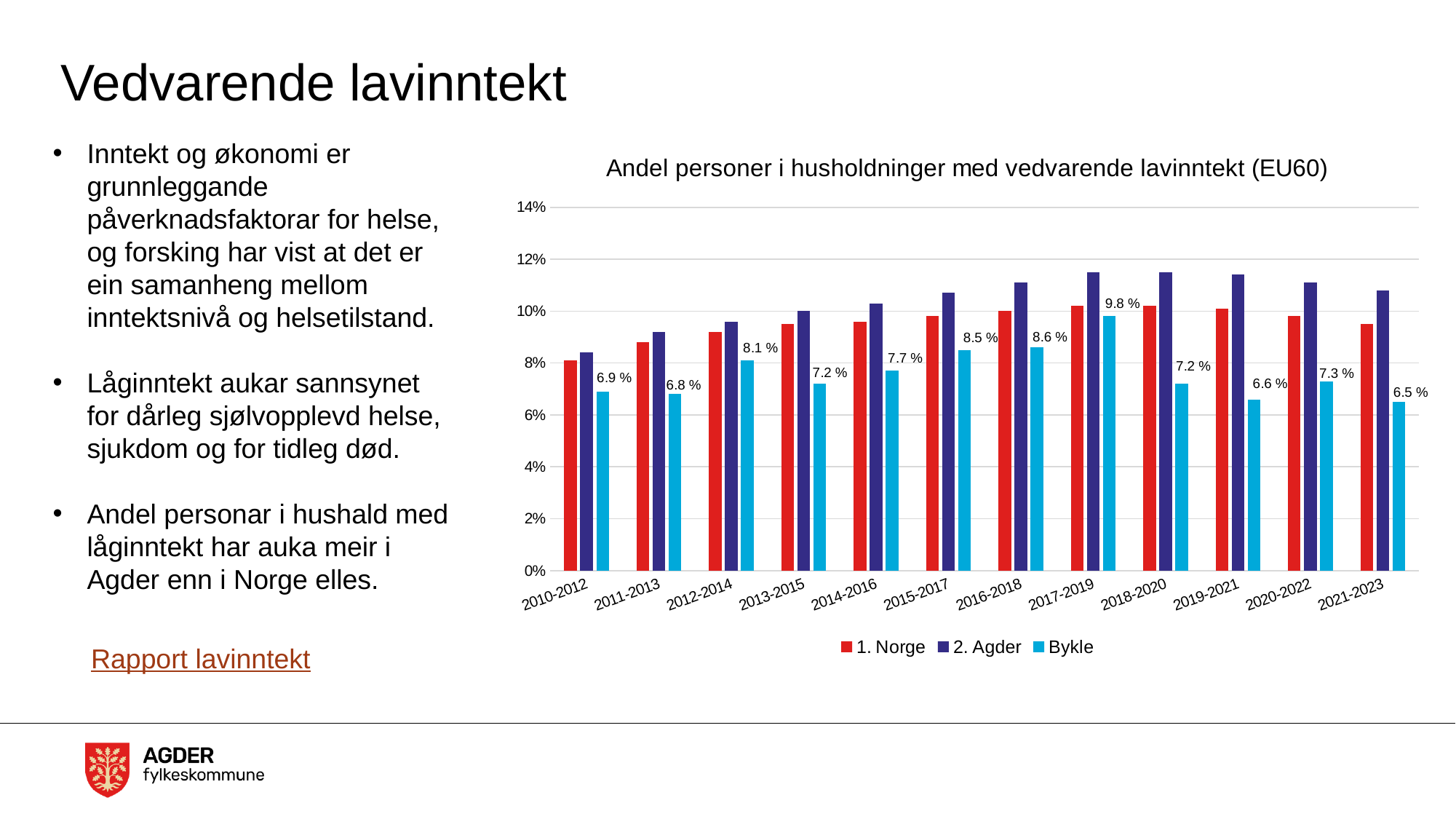
What is the difference between the Bykle value in 2017-2019 and in 2021-2023? 3.3 percentage points In which period is the Bykle value lowest? 2021-2023 What kind of chart is shown on the slide? Bar chart What is the value for Bykle in 2021-2023? 6.5 % How many series does the legend list? 3 What is the value for Bykle in 2017-2019? 9.8 % What is the value for Bykle in 2010-2012? 6.9 % Is the value for 2. Agder in 2017-2019 greater or less than 10%? greater How many periods are shown on the x axis? 12 In 2021-2023, which is larger: the value for 1. Norge or for 2. Agder? 2. Agder Is the value for 1. Norge in 2010-2012 greater or less than 10%? less In which period is the Bykle value highest? 2017-2019